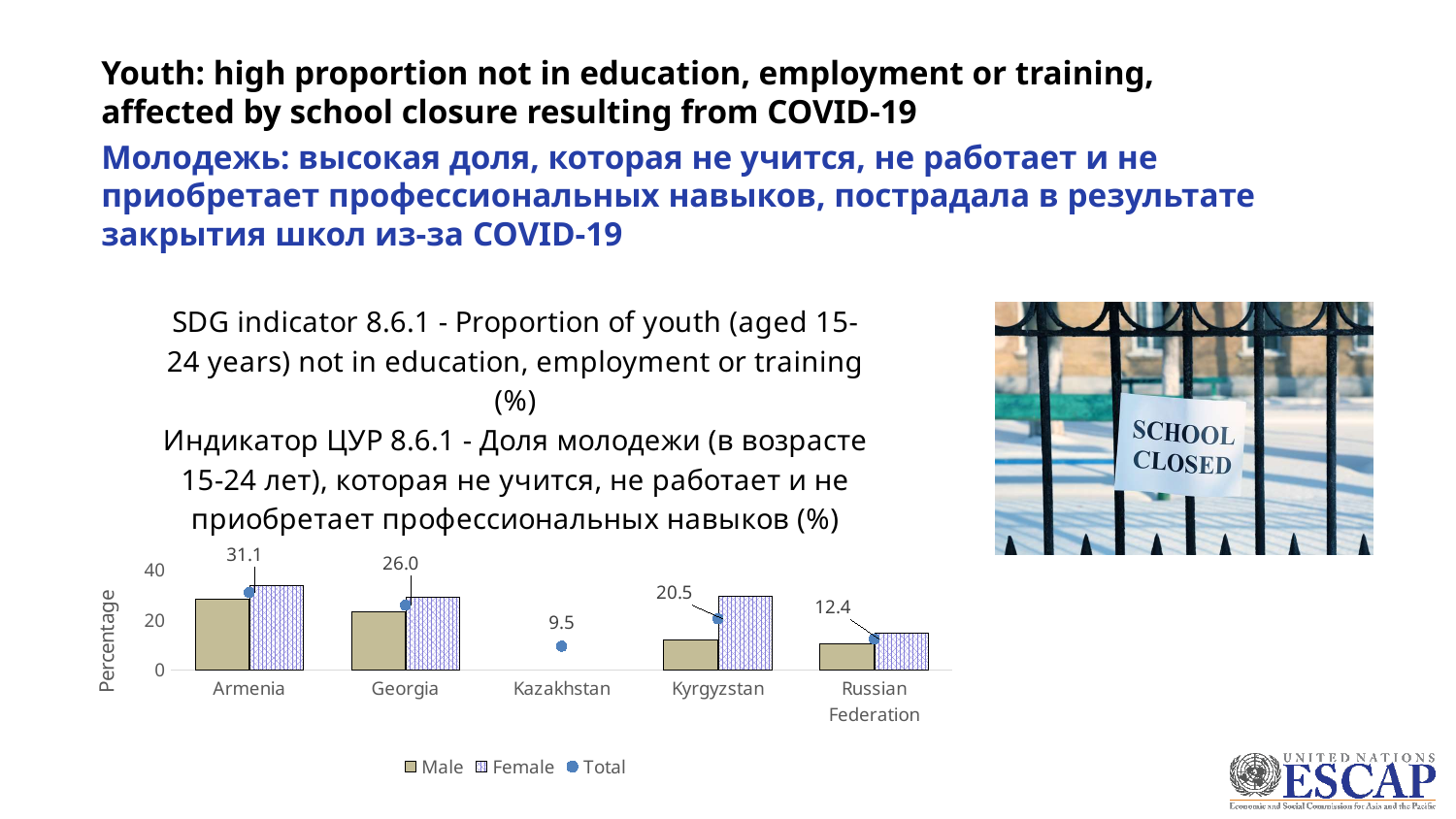
What is the label on the y axis? Percentage What is the Total value for Kyrgyzstan? 20.5 Is the Female value for Armenia greater or less than 20? greater Which has a larger Total value, Kyrgyzstan or the Russian Federation? Kyrgyzstan Is the Male value for the Russian Federation greater or less than 20? less How many series does the legend list? 3 How many countries are shown on the x axis? 5 Which country has the highest Total value? Armenia Which country has the lowest Total value? Kazakhstan What is the difference between the Total values for Armenia and Georgia? 5.1 What is the Total value for Kazakhstan? 9.5 What is the Total value for Armenia? 31.1